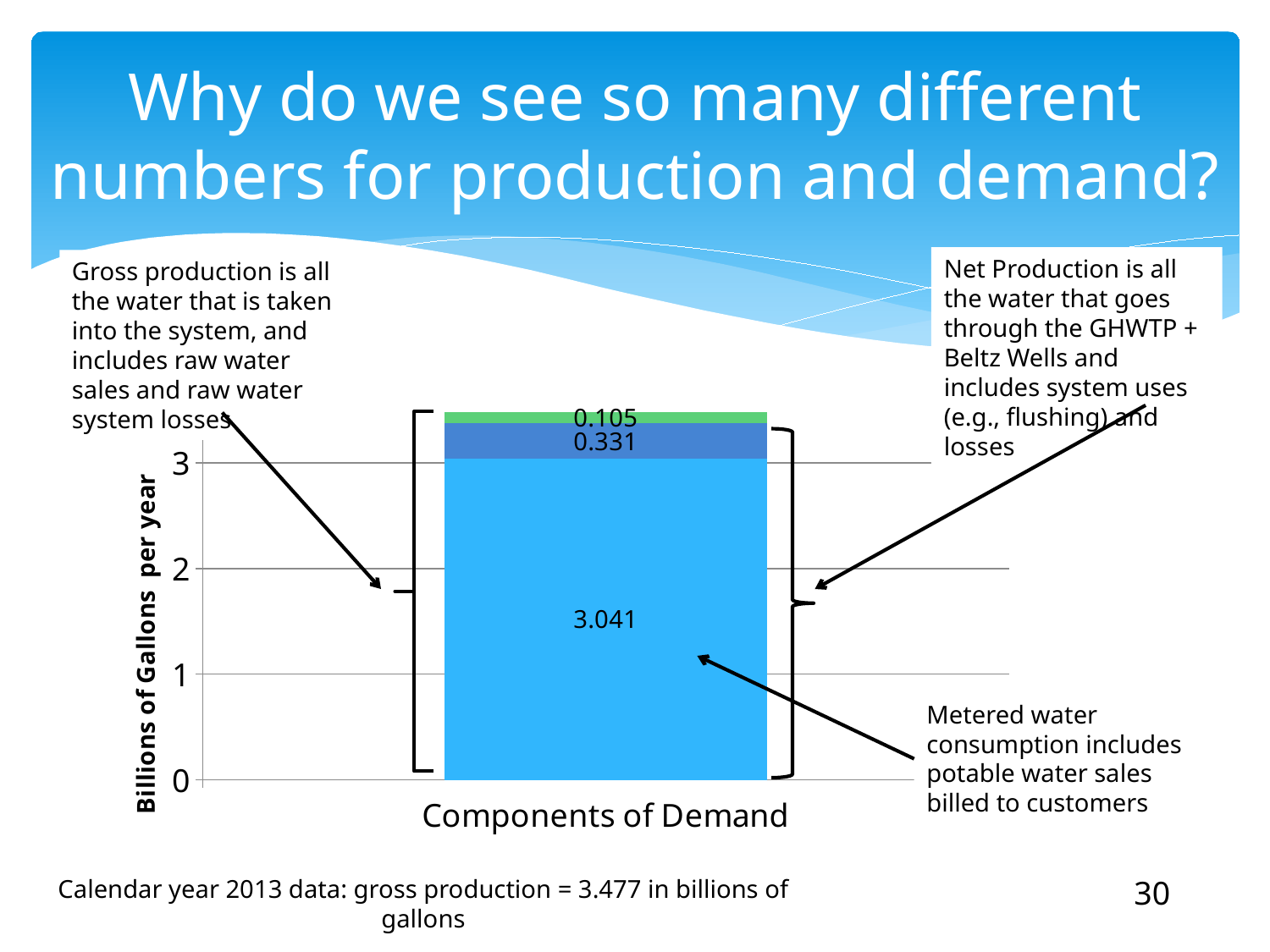
What is the title of the y axis of the chart? Billions of Gallons per year What kind of chart is shown on the slide? stacked bar chart What is the value of the smallest segment of the stacked bar? 0.105 Which is larger, the dark blue segment or the green segment? the dark blue segment What is the value of the largest segment of the stacked bar? 3.041 How many categories are shown on the x axis of the chart? 1 What is the value of the middle (dark blue) segment of the stacked bar? 0.331 What is the value of the top (green) segment of the stacked bar? 0.105 What is the difference between the largest segment (3.041) and the middle segment (0.331)? 2.710 What is the total of all segments in the stacked bar? 3.477 What is the difference between the middle segment (0.331) and the top segment (0.105)? 0.226 Is the value of the largest segment greater or less than 3? greater